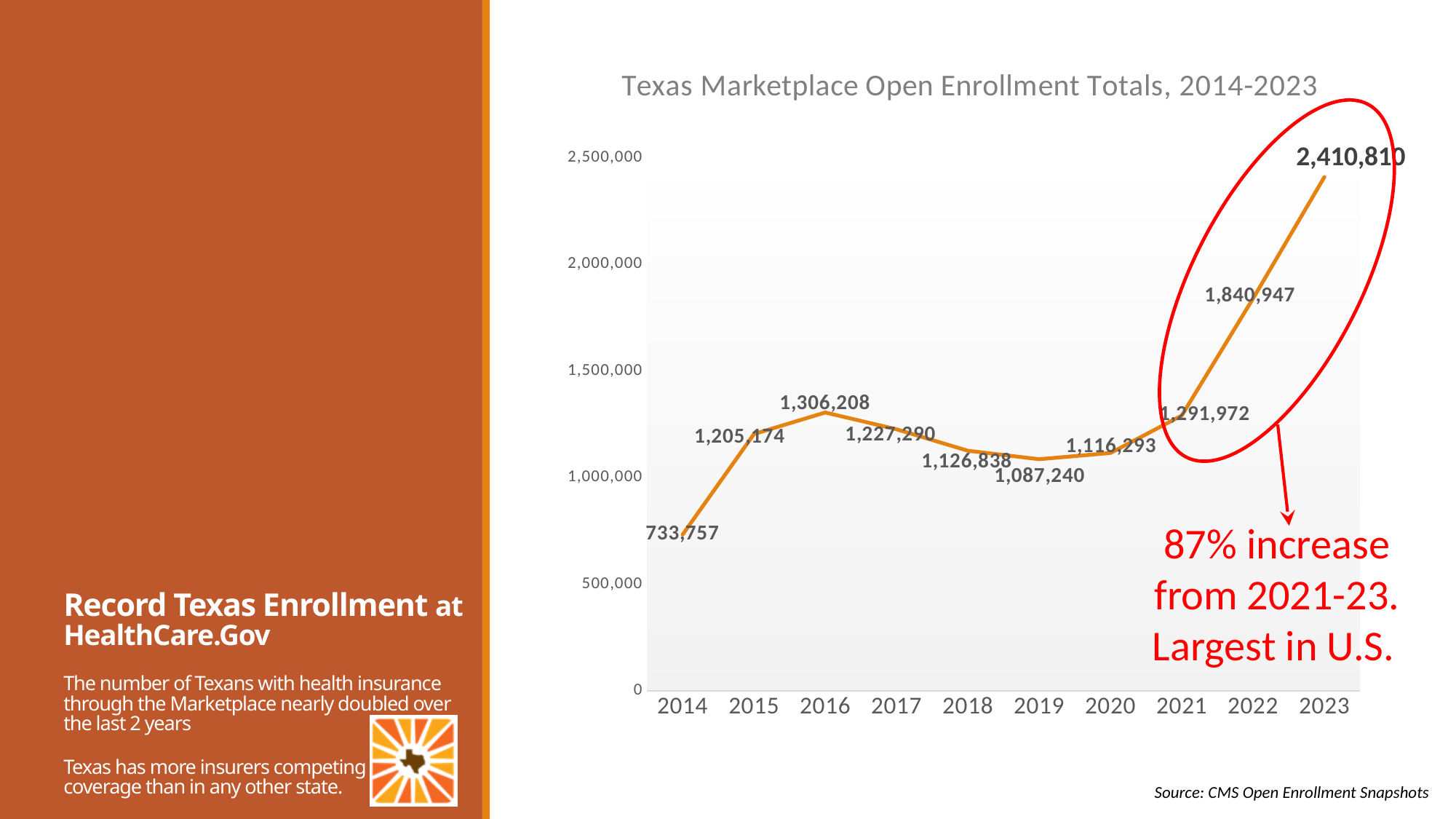
Do the enrollment totals rise or fall from 2016 to 2019? Fall What kind of chart is shown on the slide? Line chart What is the difference between the 2023 and 2022 enrollment totals? 569,863 What is the enrollment total for 2014? 733,757 What is the enrollment total for 2023? 2,410,810 Which year has the lowest enrollment total? 2014 How many years are plotted on the chart? 10 Which year has a larger enrollment total, 2016 or 2020? 2016 What is the enrollment total for 2022? 1,840,947 What is the difference between the 2022 and 2021 enrollment totals? 548,975 Which year has the highest enrollment total? 2023 What is the enrollment total for 2019? 1,087,240